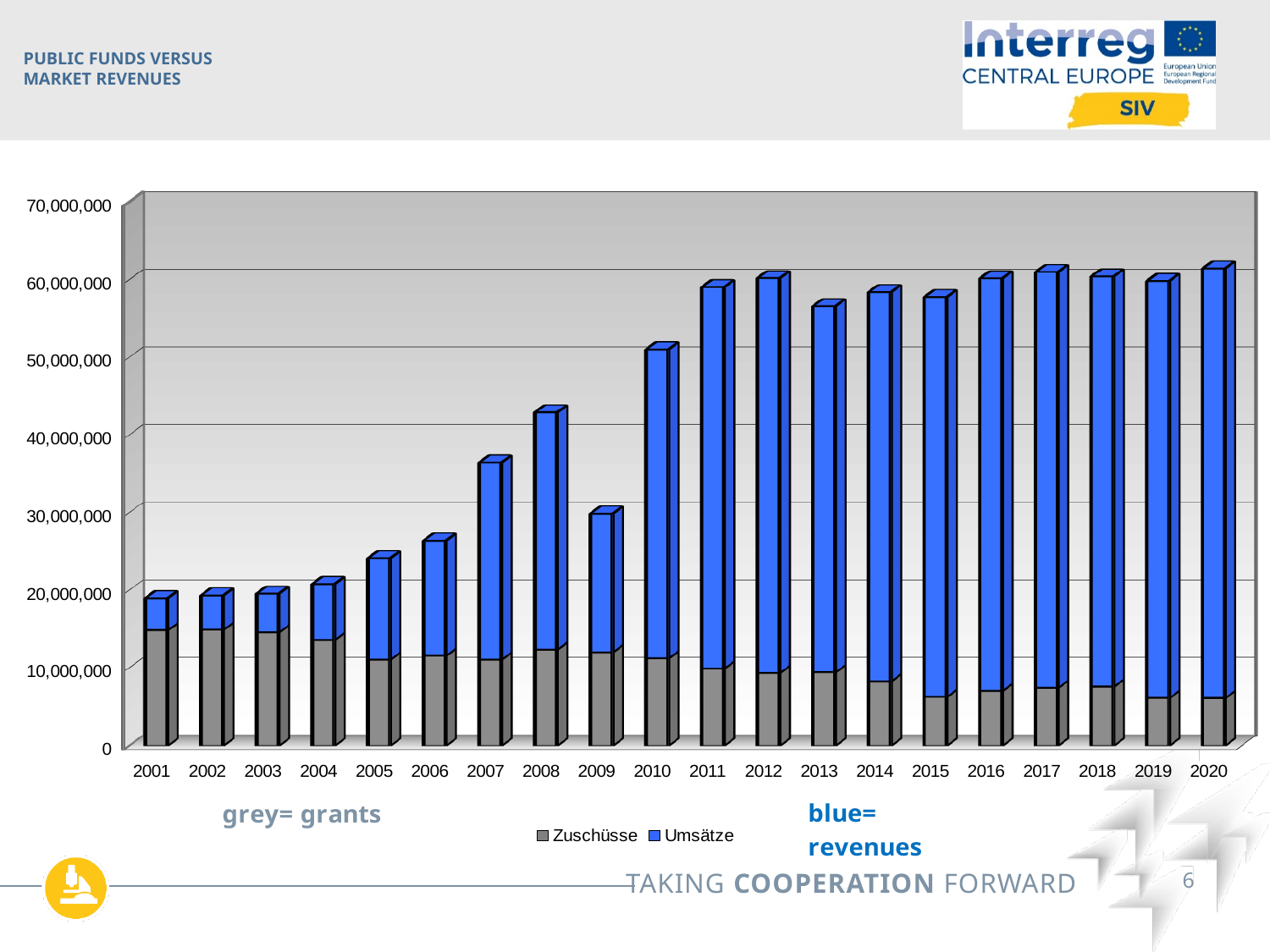
How many years are shown along the x axis of the chart? 20 What are the two series named in the chart's legend? Zuschüsse and Umsätze Do the Umsätze (blue) values generally rise or fall from 2001 to 2020? Rise Which colour represents grants (Zuschüsse) in the chart? Grey What kind of chart is shown on the slide? Stacked bar chart Which year has the larger total bar, 2008 or 2009? 2008 Is the total bar height for 2013 greater or less than 60,000,000? less Is the Zuschüsse (grey) value for 2020 greater or less than 10,000,000? less How many series does the chart's legend list? 2 Is the Zuschüsse (grey) value for 2001 greater or less than 10,000,000? greater